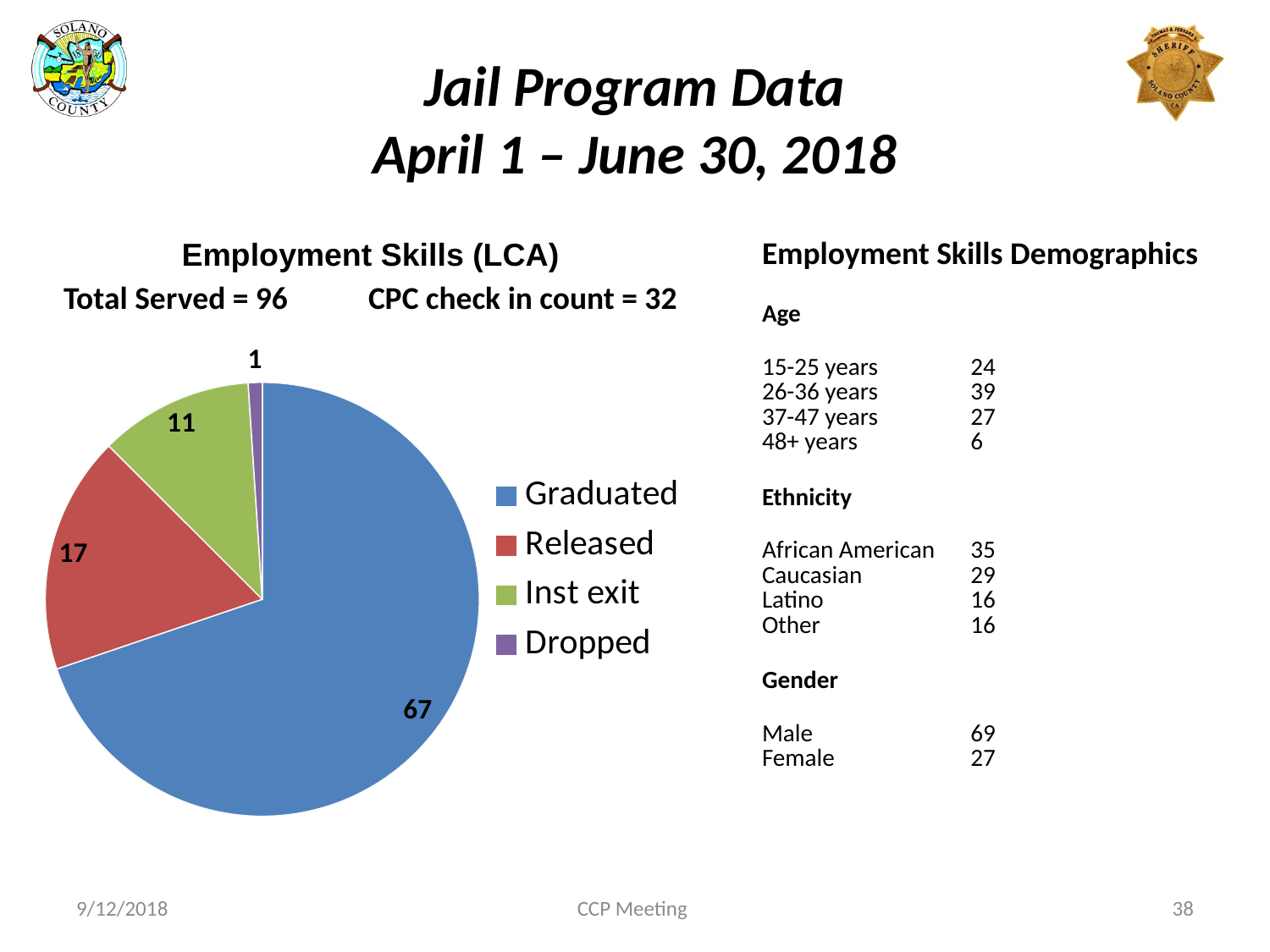
In the Employment Skills (LCA) pie chart, what is the value for Released? 17 In the Employment Skills (LCA) pie chart, what is the difference between the Graduated and Released values? 50 In the Employment Skills (LCA) pie chart, what is the value for Graduated? 67 Which category has the largest slice in the Employment Skills (LCA) pie chart? Graduated Which category has the smallest slice in the Employment Skills (LCA) pie chart? Dropped In the Employment Skills (LCA) pie chart, what is the difference between the Released and Inst exit values? 6 In the Employment Skills (LCA) pie chart, which is larger, Released or Inst exit? Released What is the total of all slices in the Employment Skills (LCA) pie chart? 96 In the Employment Skills (LCA) pie chart, what is the value for Dropped? 1 What type of chart is the Employment Skills (LCA) chart? pie chart How many categories does the Employment Skills (LCA) pie chart show? 4 In the Employment Skills (LCA) pie chart, what is the value for Inst exit? 11